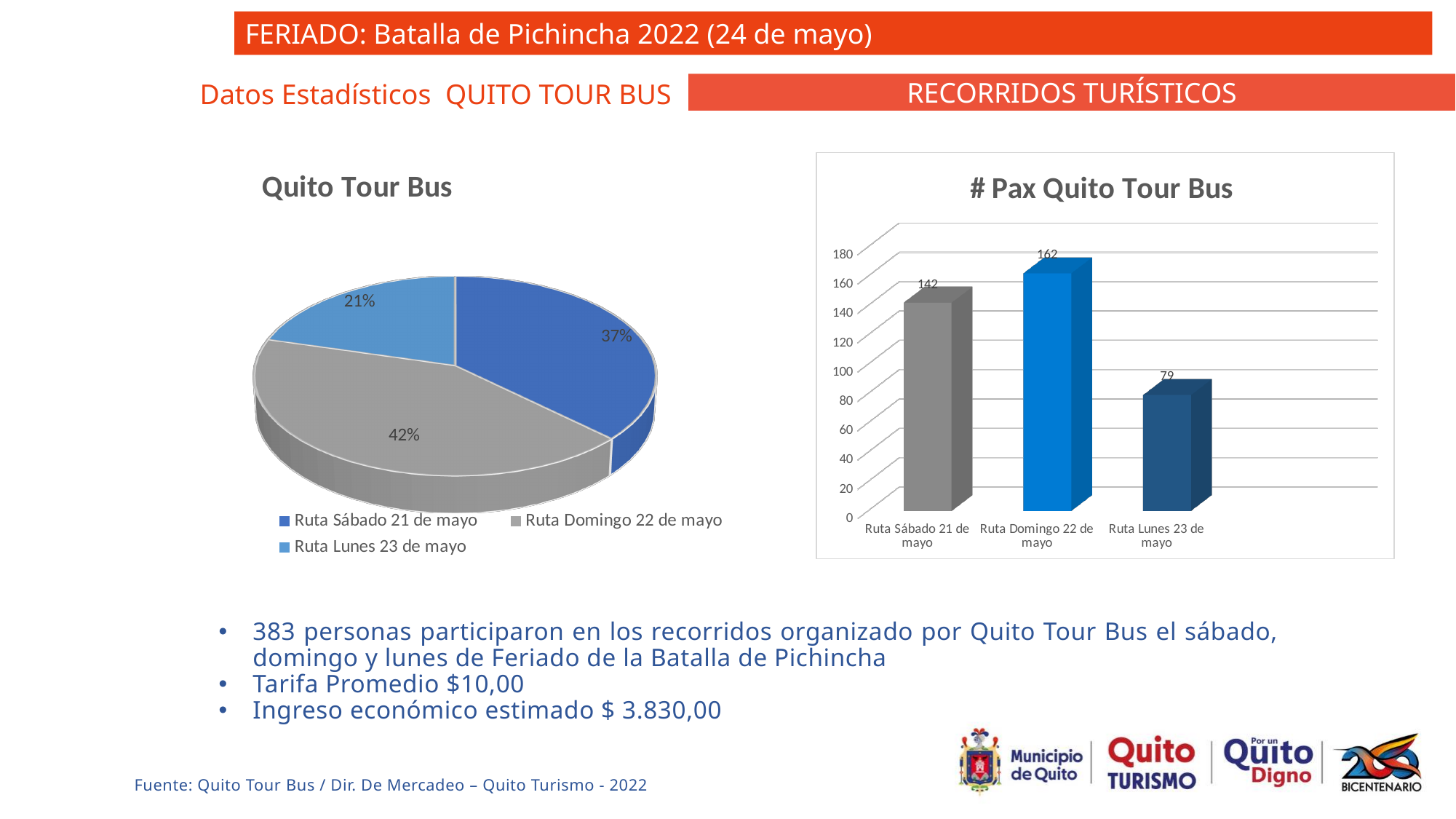
How many entries does the legend of the 'Quito Tour Bus' pie chart list? 3 What type of chart is the '# Pax Quito Tour Bus' chart? Bar chart In the '# Pax Quito Tour Bus' chart, what is the value for Ruta Lunes 23 de mayo? 79 In the '# Pax Quito Tour Bus' chart, what is the difference between Ruta Domingo 22 de mayo and Ruta Sábado 21 de mayo? 20 In the '# Pax Quito Tour Bus' chart, how many passengers are shown for Ruta Domingo 22 de mayo? 162 In the 'Quito Tour Bus' pie chart, what percentage is shown for Ruta Lunes 23 de mayo? 21% In the '# Pax Quito Tour Bus' chart, which route has the highest number of passengers? Ruta Domingo 22 de mayo In the '# Pax Quito Tour Bus' chart, which route has the lowest number of passengers? Ruta Lunes 23 de mayo What type of chart is the 'Quito Tour Bus' chart on the left? Pie chart In the 'Quito Tour Bus' pie chart, what share does Ruta Domingo 22 de mayo have? 42% In the '# Pax Quito Tour Bus' chart, how many categories are plotted? 3 In the 'Quito Tour Bus' pie chart, which slice is larger: Ruta Sábado 21 de mayo or Ruta Lunes 23 de mayo? Ruta Sábado 21 de mayo